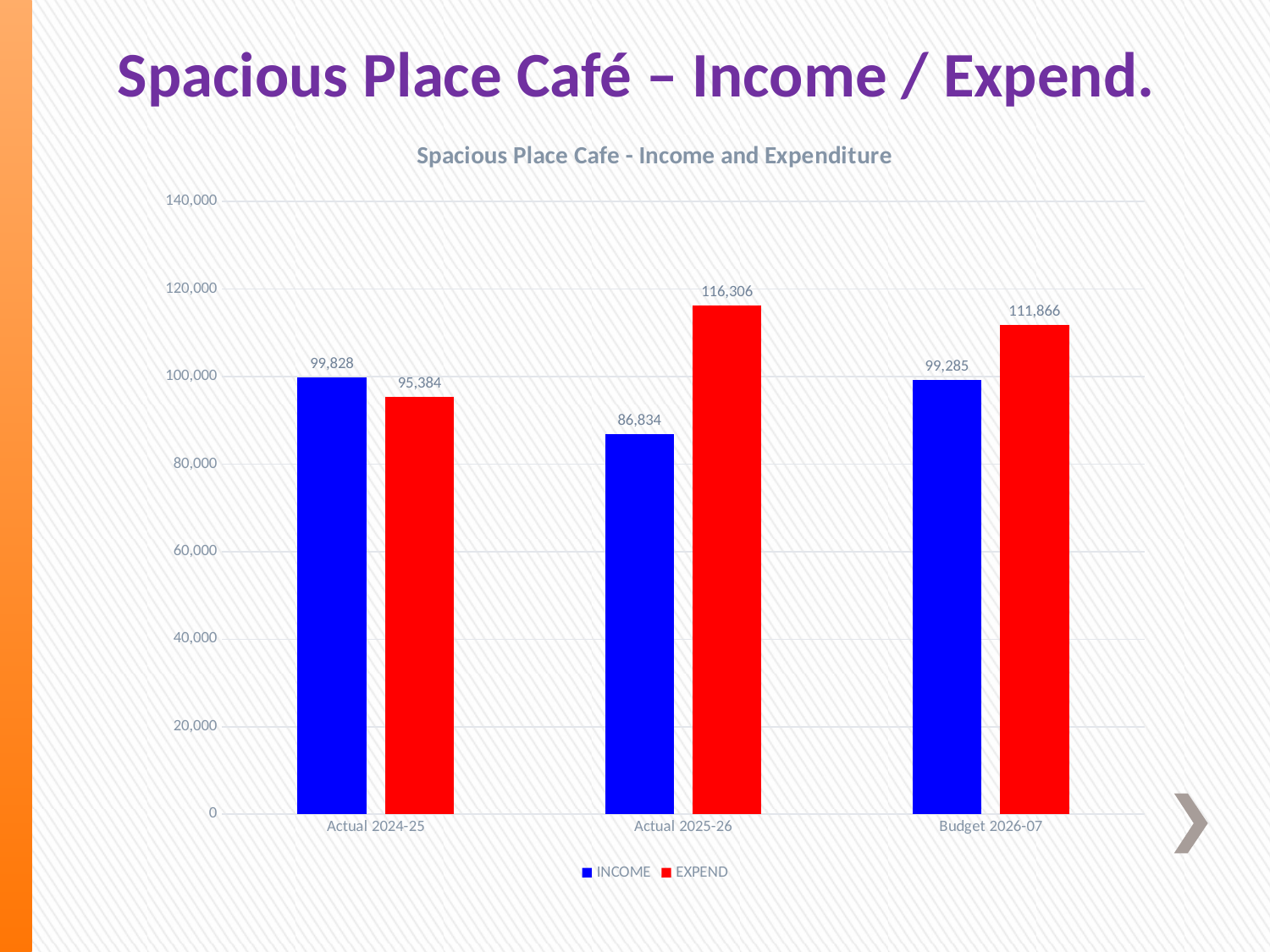
What is the EXPEND value for Actual 2024-25? 95,384 How many series does the legend list? 2 What is the INCOME value for Actual 2025-26? 86,834 Is the EXPEND value for Actual 2025-26 greater or less than 100,000? greater What is the difference between EXPEND and INCOME for Actual 2025-26? 29,472 What is the difference between EXPEND and INCOME for Budget 2026-07? 12,581 How many categories are shown on the x axis? 3 Which category has the highest EXPEND value? Actual 2025-26 For Actual 2024-25, which is larger, INCOME or EXPEND? INCOME What type of chart is shown on the slide? Bar chart What is the EXPEND value for Budget 2026-07? 111,866 Which category has the lowest INCOME value? Actual 2025-26